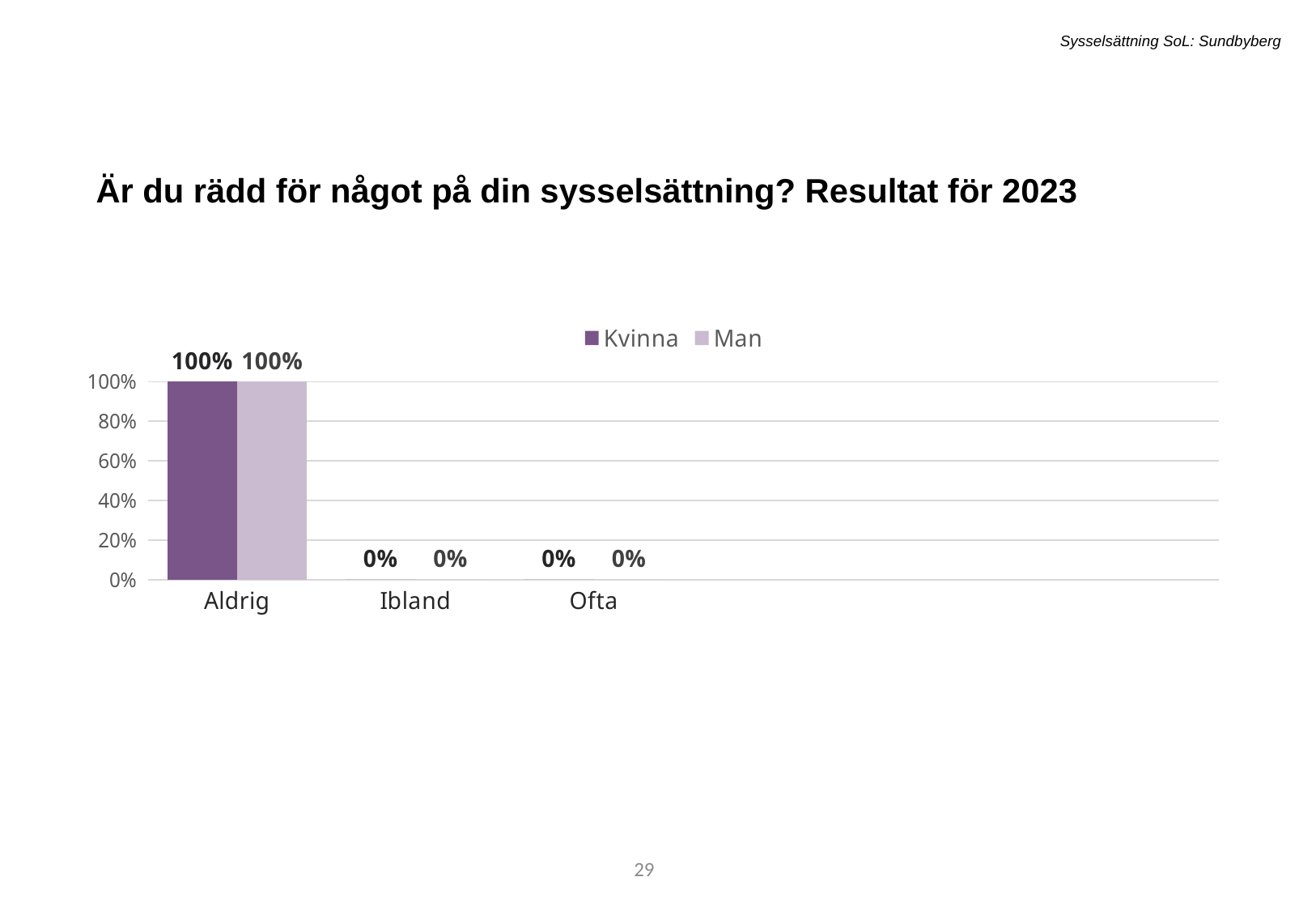
How many series does the legend list? 2 How many categories are shown on the x axis? 3 What are the two series named in the legend? Kvinna and Man Do the Kvinna values rise or fall from Aldrig to Ofta? Fall What is the value for Man in the Aldrig category? 100% What is the difference between the Kvinna values for Aldrig and Ibland? 100% What is the value for Man in the Ofta category? 0% Which is larger: the Man value for Aldrig or the Man value for Ofta? Aldrig What is the value for Kvinna in the Aldrig category? 100% Which category has the highest value for Kvinna? Aldrig What is the value for Kvinna in the Ibland category? 0% What kind of chart is shown on the slide? Bar chart